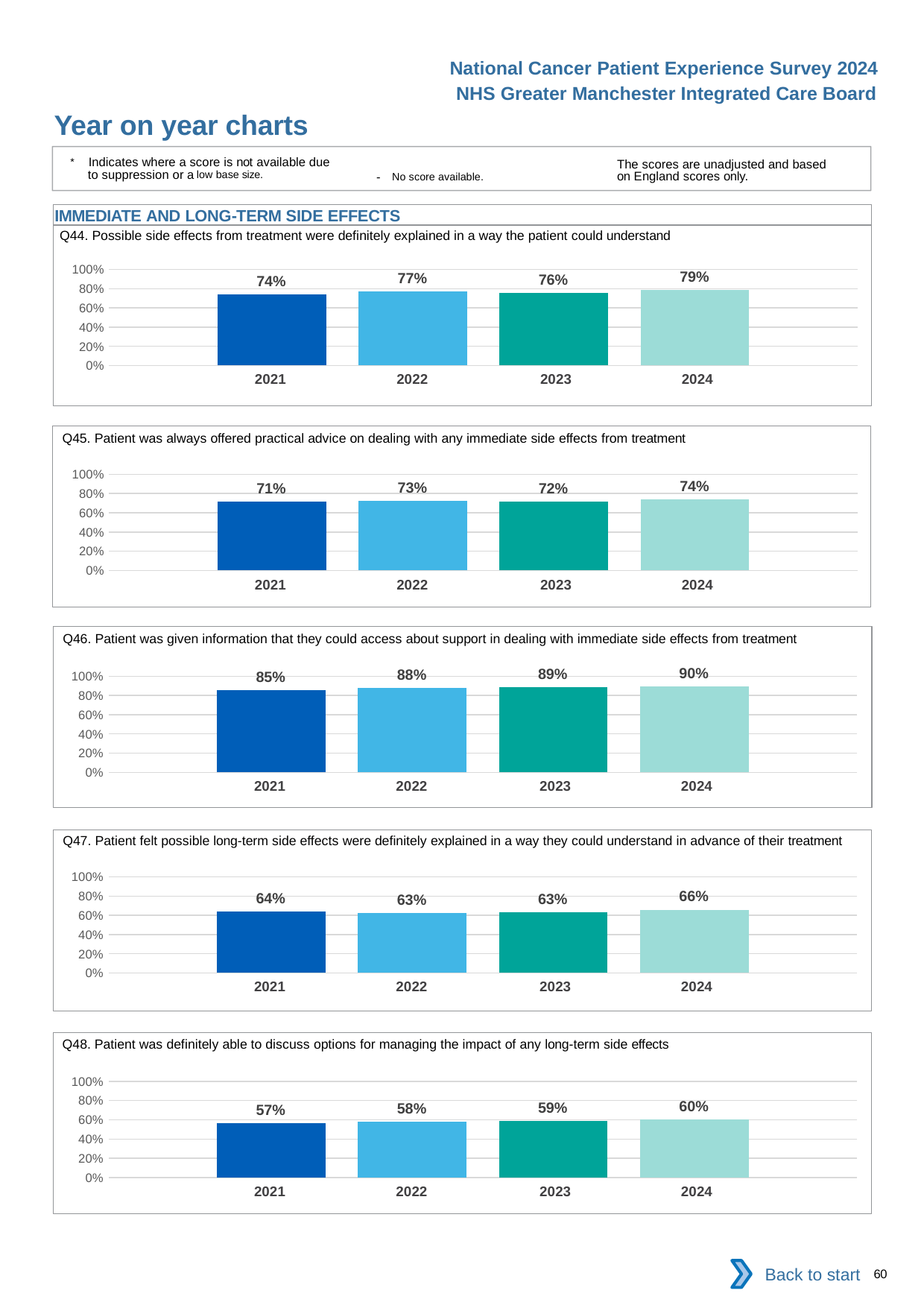
In the Q47 chart, which is larger, the value for 2021 or the value for 2024? 2024 In the Q48 chart, is the value for 2024 greater or less than 80%? less In the Q45 chart, which year has the highest value? 2024 In the Q48 chart, what is the value for 2021? 57% In the Q44 chart, what is the value for 2024? 79% In the Q47 chart, what is the value for 2023? 63% What kind of chart is the Q44 chart? bar chart In the Q44 chart, which year has the lowest value? 2021 In the Q45 chart, what is the difference between the 2024 and 2021 values? 3 percentage points In the Q46 chart, what is the value for 2022? 88% How many years are shown in the Q48 chart? 4 In the Q46 chart, do the values rise or fall from 2021 to 2024? rise